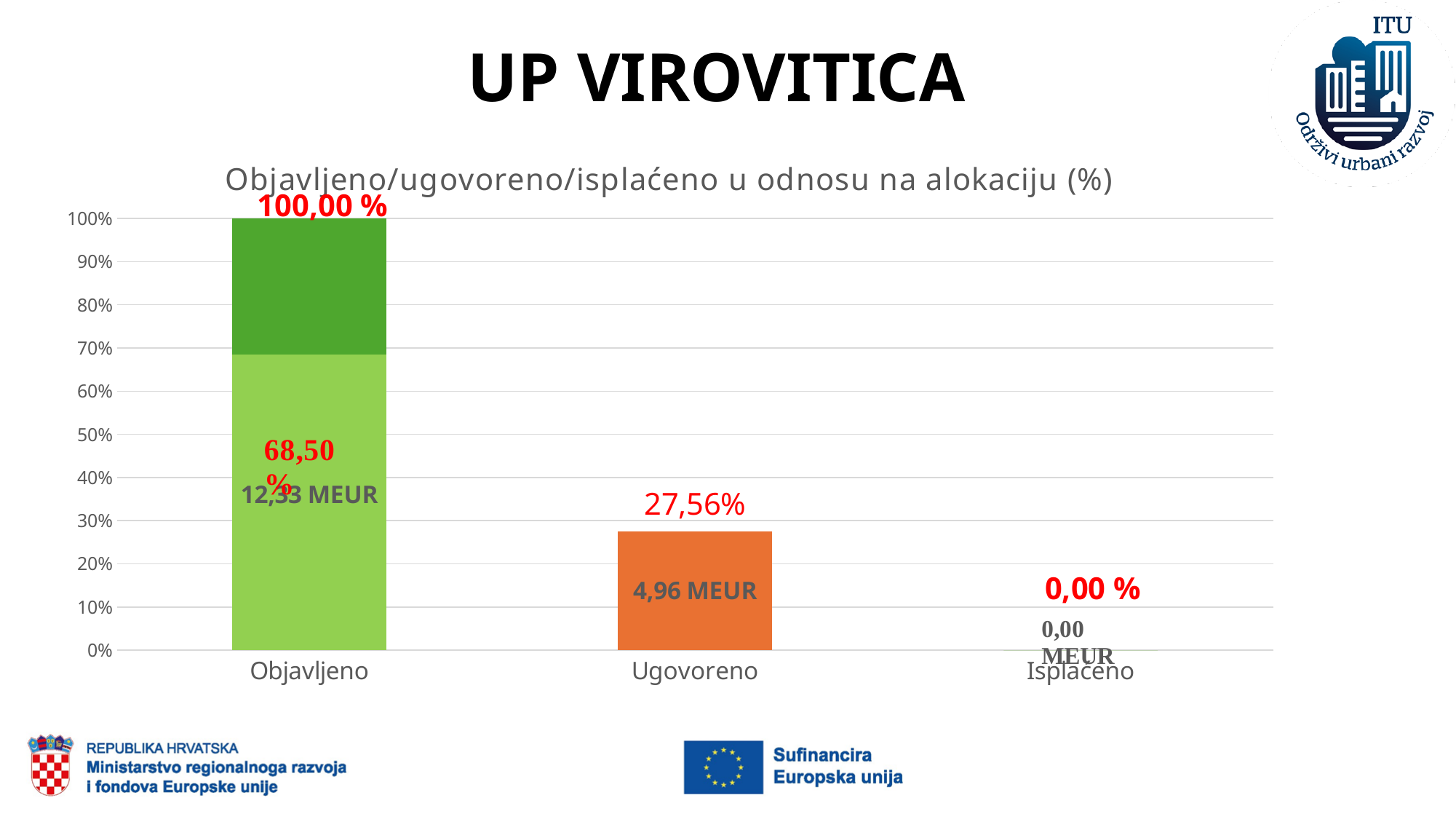
What percentage value is shown for Isplaćeno? 0,00 % Which category has the highest value? Objavljeno What MEUR amount is labelled on the Ugovoreno bar? 4,96 MEUR Is the value for Ugovoreno greater or less than 30%? less How many categories are shown on the x axis? 3 What percentage is labelled on the lighter green portion of the Objavljeno bar? 68,50 % What is the title of the chart? Objavljeno/ugovoreno/isplaćeno u odnosu na alokaciju (%) What MEUR amount is labelled on the Objavljeno bar? 12,33 MEUR What percentage value is shown for Ugovoreno? 27,56% What is the difference in MEUR between Objavljeno (12,33 MEUR) and Ugovoreno (4,96 MEUR)? 7,37 MEUR What percentage value is shown at the top of the Objavljeno bar? 100,00 % Which category has the lowest value? Isplaćeno